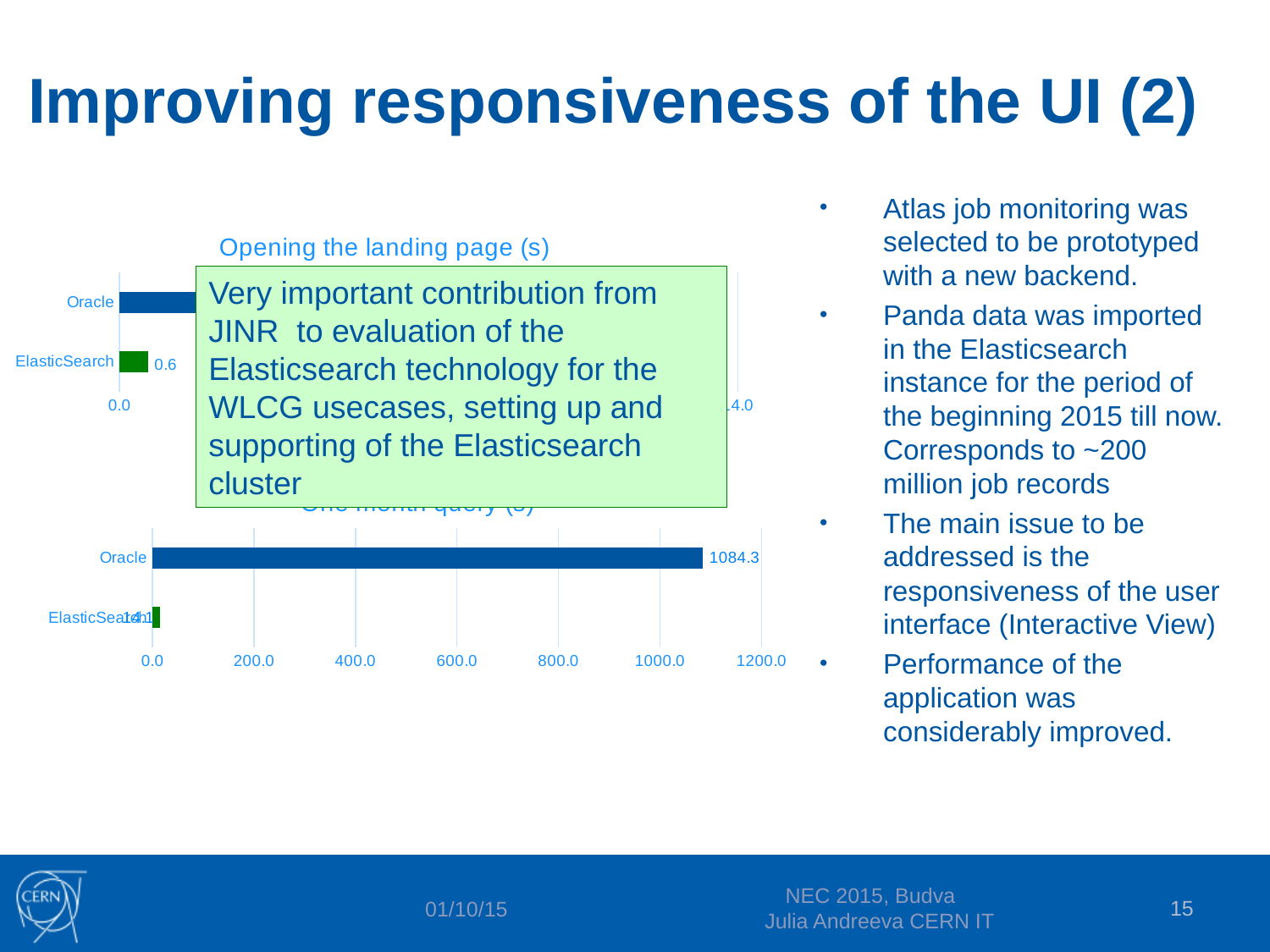
What kind of chart is the bottom chart on the slide? bar chart In the bottom chart, what is the value for Oracle? 1084.3 In the bottom chart, is the value for ElasticSearch greater or less than 200.0? less In the bottom chart, is the value for Oracle greater or less than 1000.0? greater In the bottom chart, which is larger, the value for Oracle or the value for ElasticSearch? Oracle How many categories are shown in the bottom chart? 2 How many categories are shown in the top chart titled 'Opening the landing page (s)'? 2 In the top chart titled 'Opening the landing page (s)', what is the value for ElasticSearch? 0.6 In the bottom chart, which category has the lowest value? ElasticSearch What kind of chart is the top chart titled 'Opening the landing page (s)'? bar chart In the bottom chart, which category has the highest value? Oracle What is the title of the top chart on the slide? Opening the landing page (s)